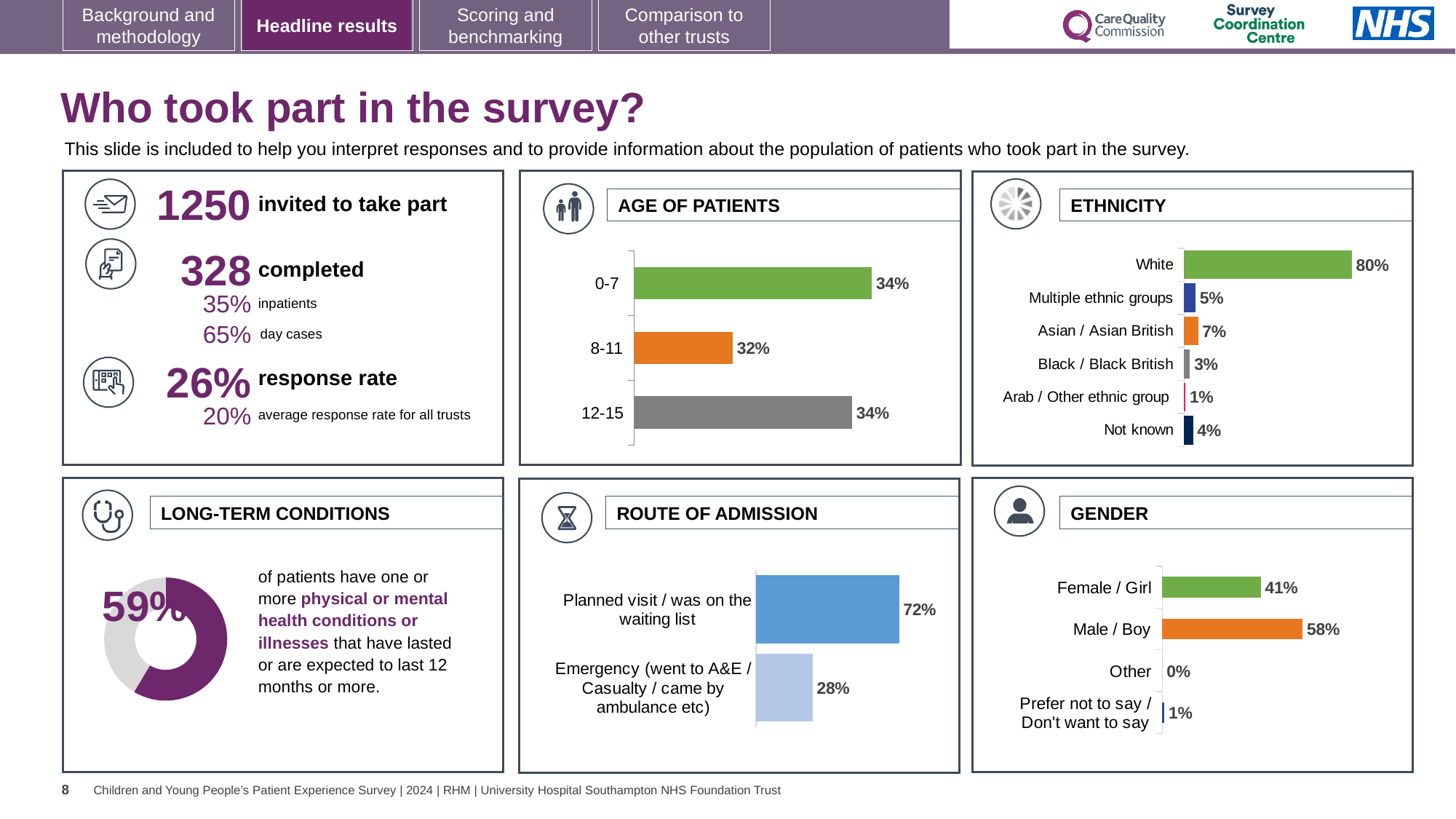
In the ROUTE OF ADMISSION chart, what percentage of patients had a planned visit / were on the waiting list? 72% In the GENDER chart, which is larger, Female / Girl or Male / Boy? Male / Boy In the AGE OF PATIENTS chart, what percentage of patients were aged 8-11? 32% In the ETHNICITY chart, which category has the highest percentage? White In the ETHNICITY chart, what percentage of patients were Asian / Asian British? 7% How many age groups are shown in the AGE OF PATIENTS chart? 3 In the ETHNICITY chart, what is the difference between the White and Not known percentages? 76% How many ethnicity categories are shown in the ETHNICITY chart? 6 In the AGE OF PATIENTS chart, which age group has the lowest percentage? 8-11 What kind of chart is used in the LONG-TERM CONDITIONS panel? Donut chart In the GENDER chart, what percentage of patients answered Prefer not to say / Don't want to say? 1% In the ROUTE OF ADMISSION chart, what is the difference between the planned visit and emergency percentages? 44%